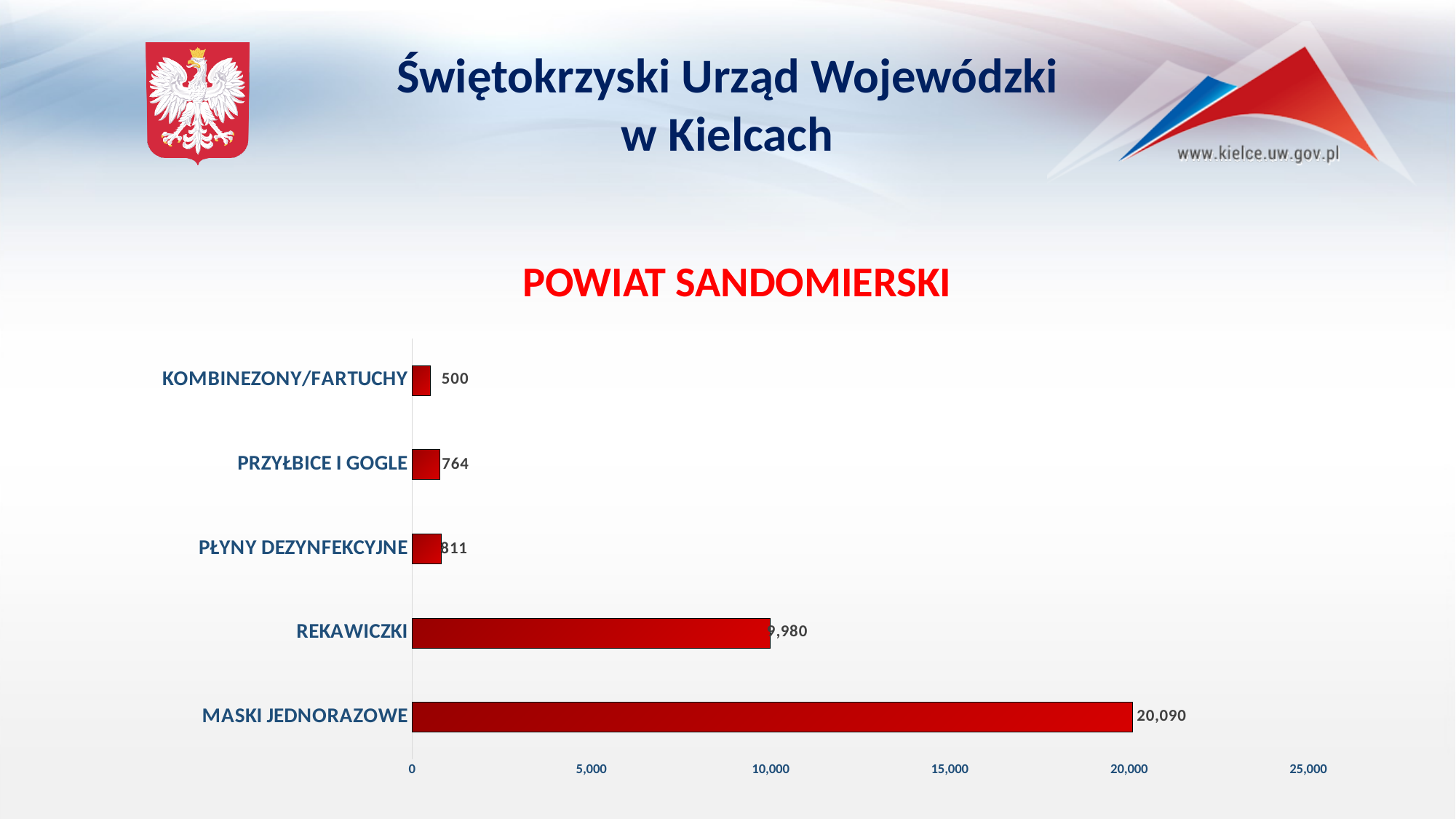
What is the value for PŁYNY DEZYNFEKCYJNE? 811 How many categories are shown in the chart? 5 What is the value for KOMBINEZONY/FARTUCHY? 500 Which category has the highest value? MASKI JEDNORAZOWE What is the value for PRZYŁBICE I GOGLE? 764 Which is larger, the value for REKAWICZKI or the value for PŁYNY DEZYNFEKCYJNE? REKAWICZKI What is the difference between the values for MASKI JEDNORAZOWE and KOMBINEZONY/FARTUCHY? 19,590 Which category has the lowest value? KOMBINEZONY/FARTUCHY What is the value for MASKI JEDNORAZOWE? 20,090 What type of chart is shown on the slide? bar chart What is the difference between the values for PŁYNY DEZYNFEKCYJNE and PRZYŁBICE I GOGLE? 47 Is the value for REKAWICZKI greater or less than 5,000? greater